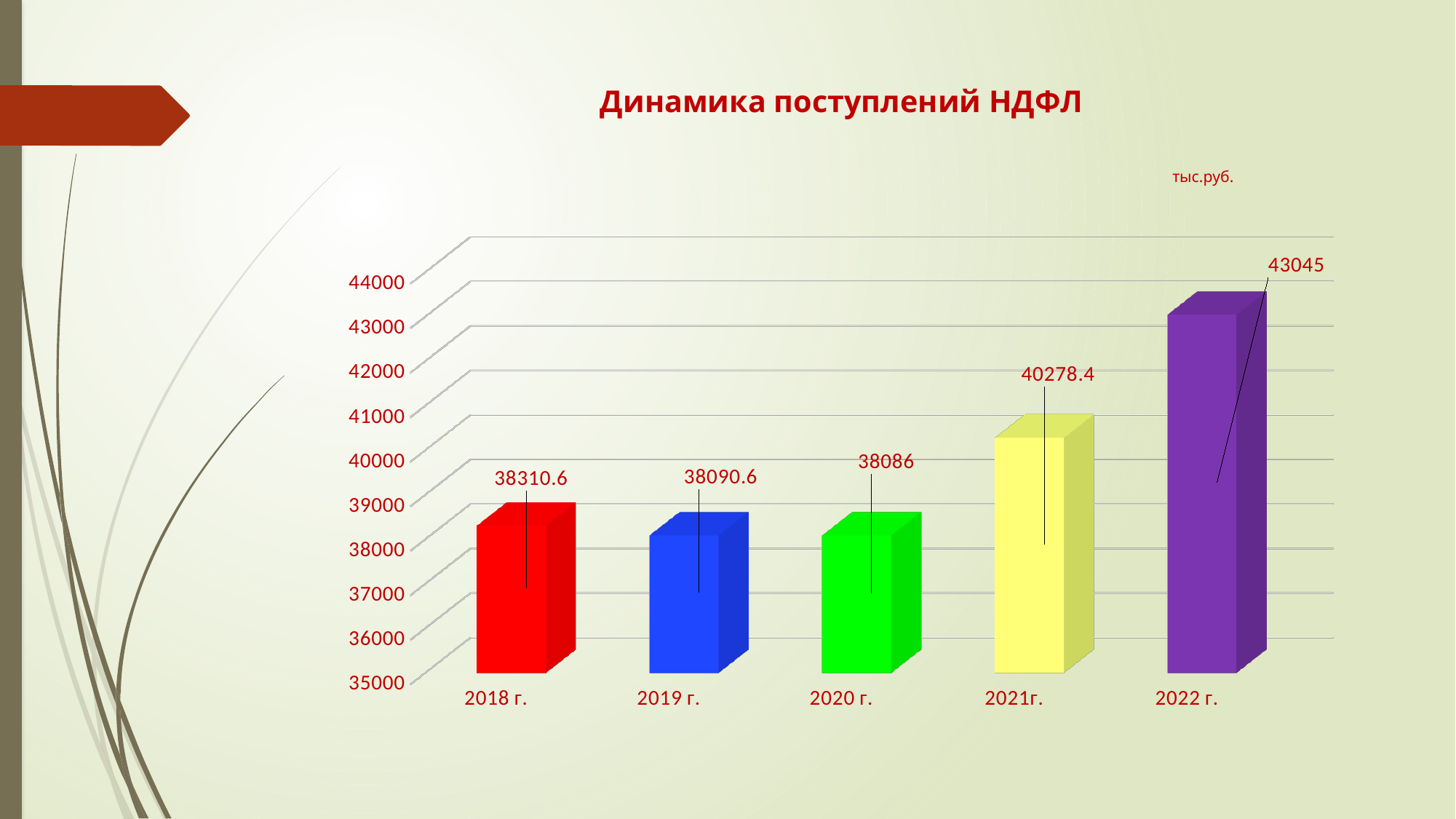
How many years are shown on the chart? 5 What is the value for 2018 г.? 38310.6 Which is larger, the value for 2021г. or the value for 2018 г.? 2021г. Is the value for 2022 г. greater or less than 42000? greater What is the difference between the values for 2022 г. and 2021г.? 2766.6 Which year has the highest value? 2022 г. What is the value for 2022 г.? 43045 What is the value for 2021г.? 40278.4 What kind of chart is shown on the slide? bar chart What is the title of the chart? Динамика поступлений НДФЛ What is the difference between the values for 2018 г. and 2019 г.? 220 What is the value for 2019 г.? 38090.6